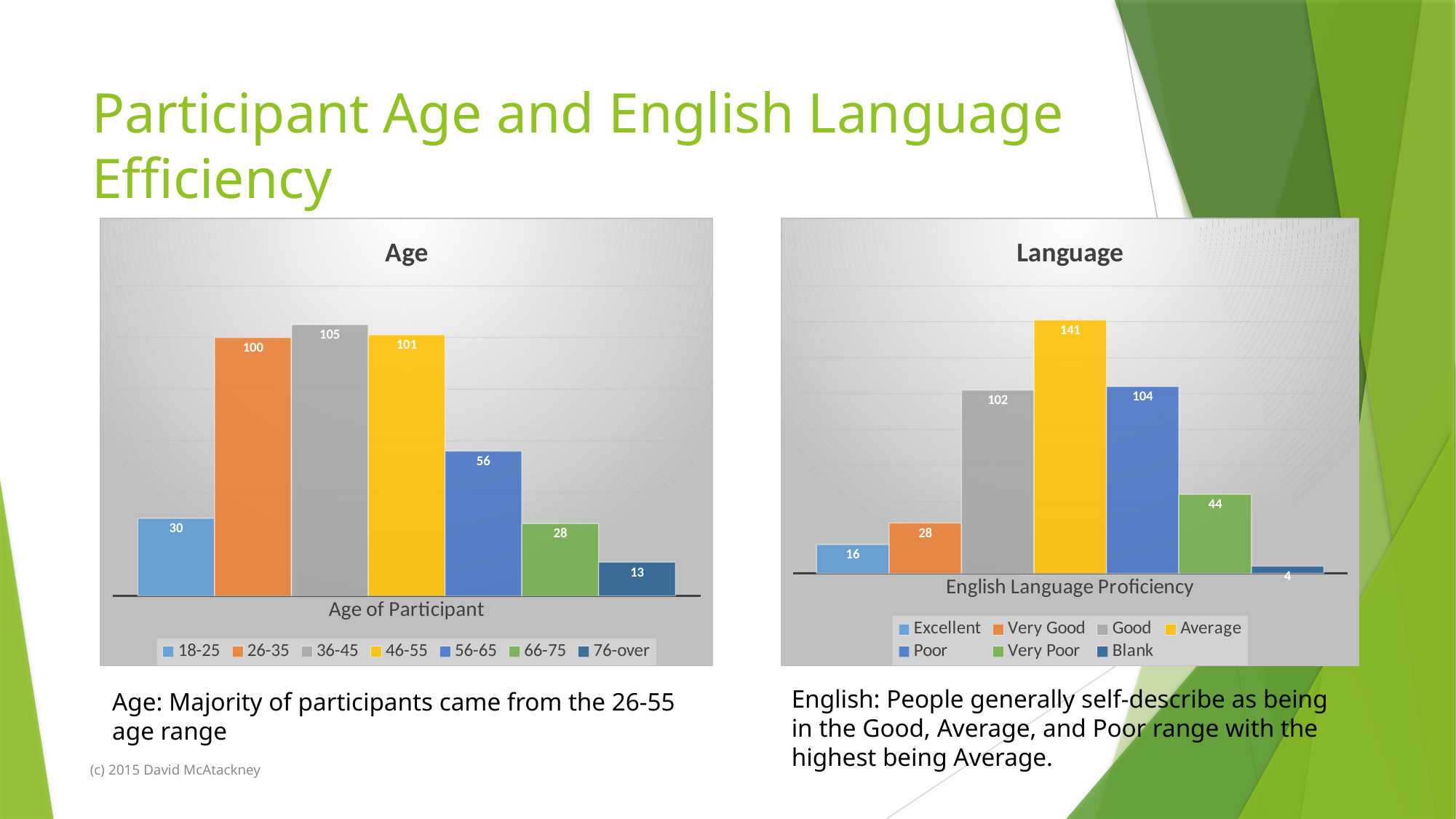
In the Age chart, what is the difference between the values for 46-55 and 56-65? 45 In the Age chart, what is the value for the 36-45 age group? 105 In the Age chart, how many age groups are plotted? 7 In the Language chart, which proficiency level has the highest value? Average In the Language chart, what is the value for Average? 141 In the Age chart, which is larger: the value for 18-25 or the value for 66-75? 18-25 In the Language chart, what is the difference between the values for Poor and Good? 2 What kind of chart is the Language chart? Bar chart In the Language chart, what is the value for Blank? 4 In the Language chart, what colour is the bar for Very Poor? Green In the Language chart, how many entries does the legend list? 7 In the Age chart, which age group has the lowest value? 76-over